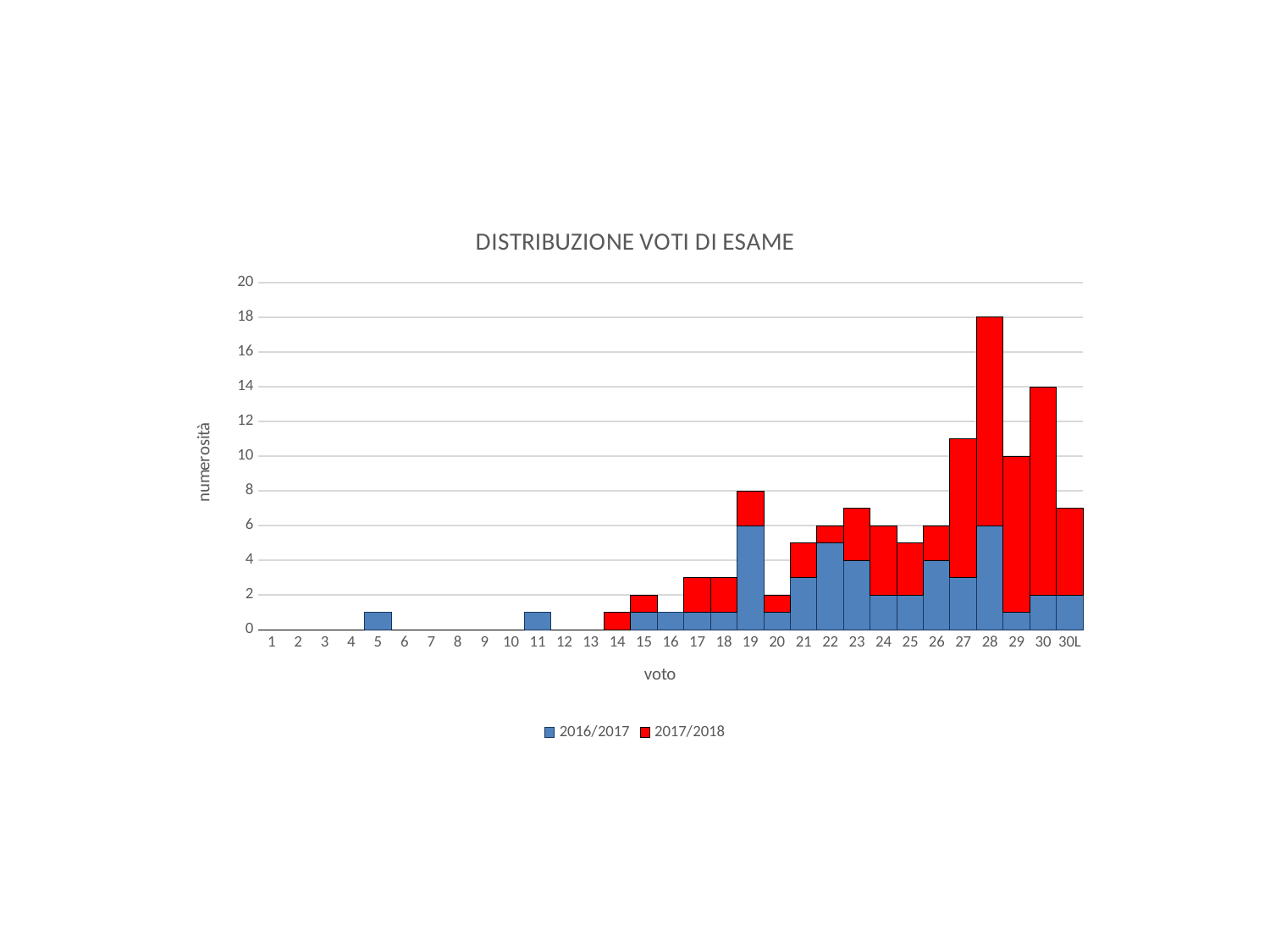
How many series does the legend list? 2 What kind of chart is shown on the slide? bar chart What is the total height of the stacked bar for voto 30? 14 What is the difference between the total for voto 28 and the total for voto 30? 4 What is the title of the chart? DISTRIBUZIONE VOTI DI ESAME Which stacked bar is taller, voto 28 or voto 30? 28 Which voto has the tallest stacked bar? 28 Is the total for voto 27 greater or less than 10? greater What is the value for 2016/2017 at voto 19? 6 What is the total height of the stacked bar for voto 28? 18 What is the total height of the stacked bar for voto 29? 10 What is the value for 2016/2017 at voto 28? 6